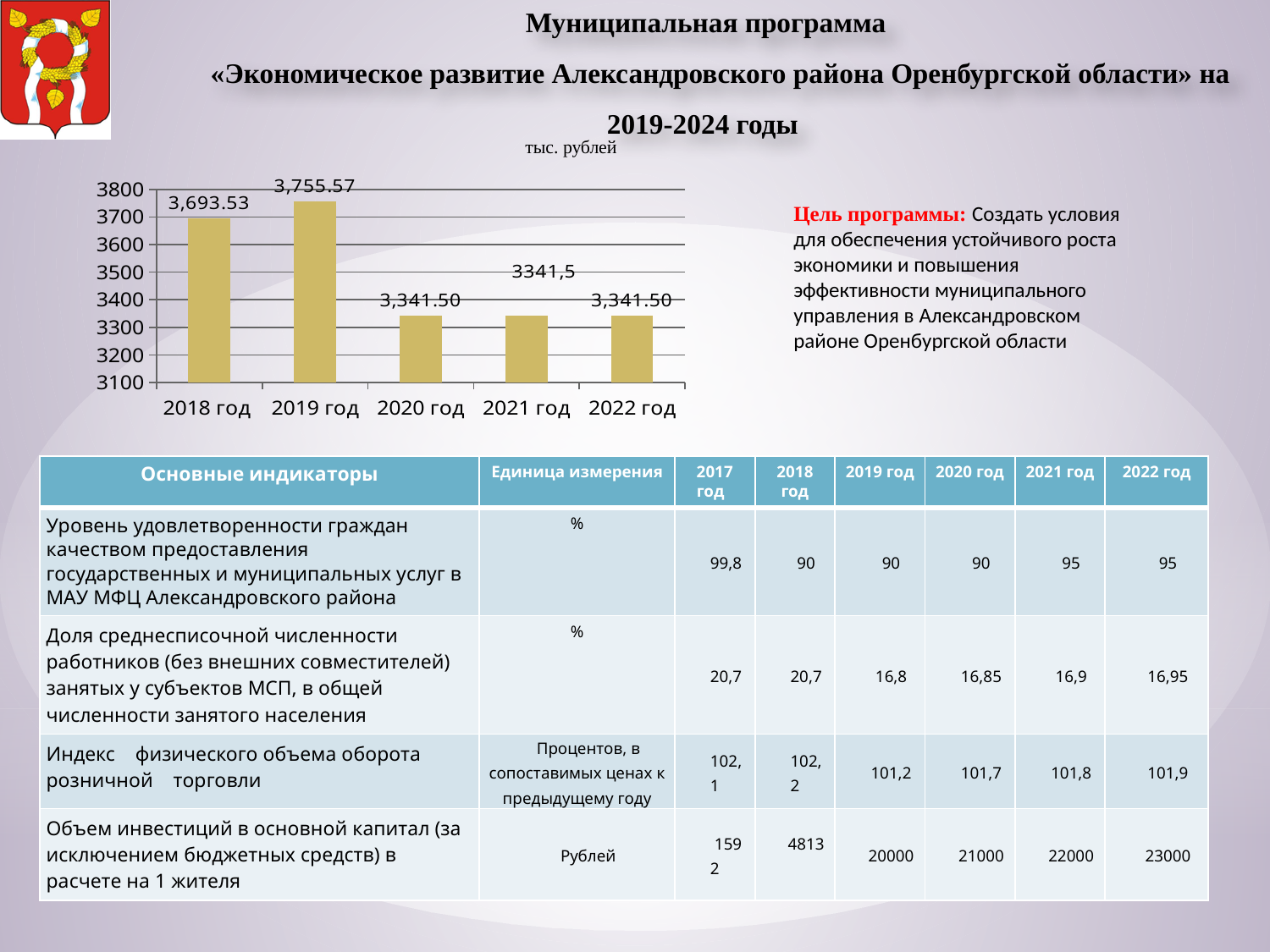
What is the difference between the values for 2019 год and 2022 год? 414.07 What is the value for 2018 год in the chart? 3,693.53 Which is larger, the value for 2018 год or the value for 2020 год? 2018 год Which year has the highest value in the chart? 2019 год What is the value for 2020 год in the chart? 3,341.50 What unit is indicated above the chart? тыс. рублей What is the value for 2019 год in the chart? 3,755.57 What kind of chart is shown on the slide? bar chart How many years (bars) are plotted in the chart? 5 What is the value labelled for 2021 год in the chart? 3341,5 What is the difference between the values for 2019 год and 2018 год? 62.04 Is the value for 2020 год greater or less than 3400? less